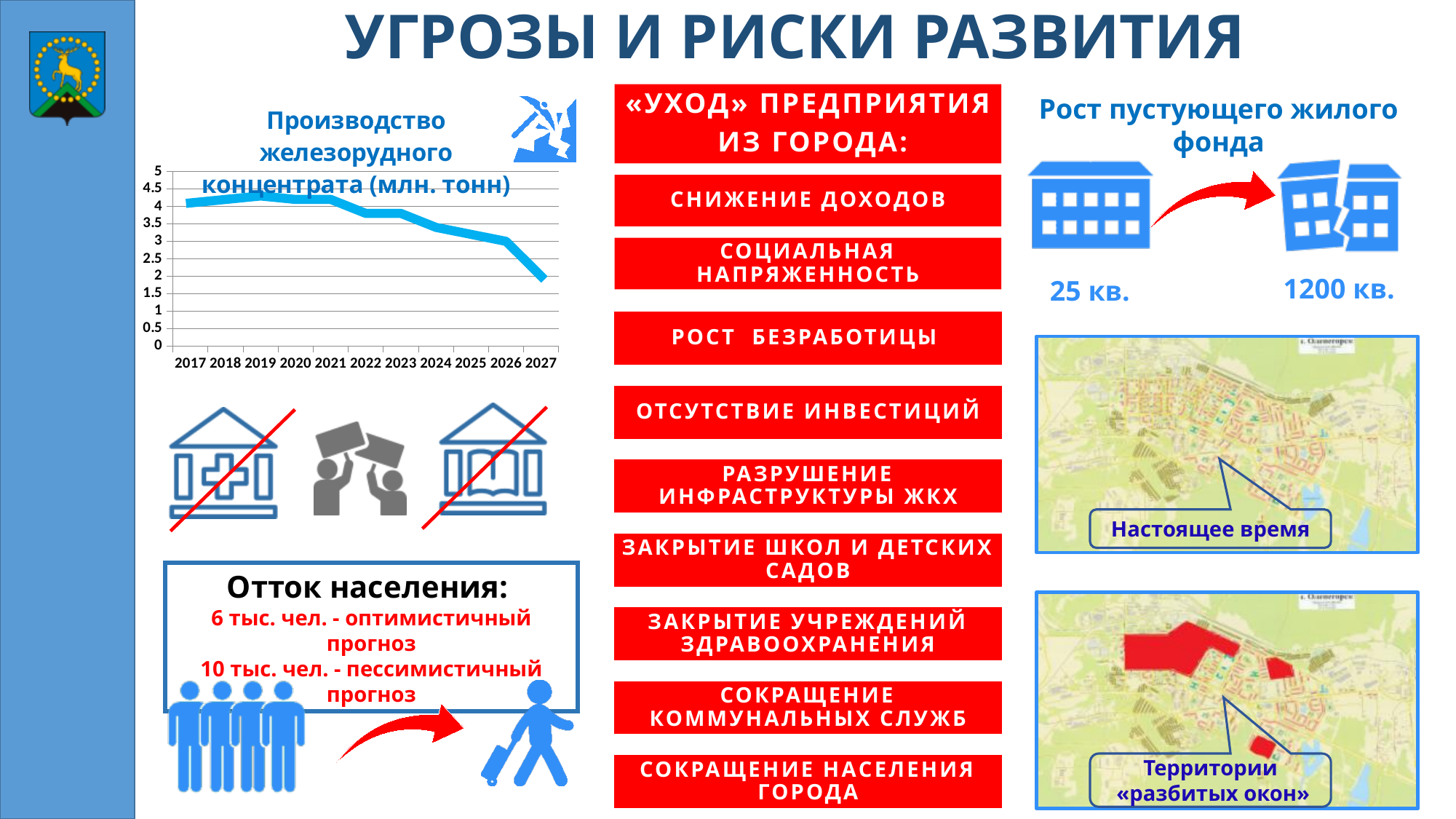
In the iron ore concentrate production chart, is the value for 2017 greater or less than 3.5? greater In the iron ore concentrate production chart, is the value for 2024 greater or less than 4? less What kind of chart is used to show the production of iron ore concentrate? line chart In the iron ore concentrate production chart, is the value for 2027 greater or less than 2.5? less In the iron ore concentrate production chart, which year has the larger value, 2017 or 2027? 2017 What is the maximum value shown on the y axis of the iron ore concentrate production chart? 5 What is the title of the line chart on the slide? Производство железорудного концентрата (млн. тонн) How many years are shown on the x axis of the iron ore concentrate production chart? 11 Which year has the lowest value in the iron ore concentrate production chart? 2027 Do the values in the iron ore concentrate production chart rise or fall from 2017 to 2027? fall